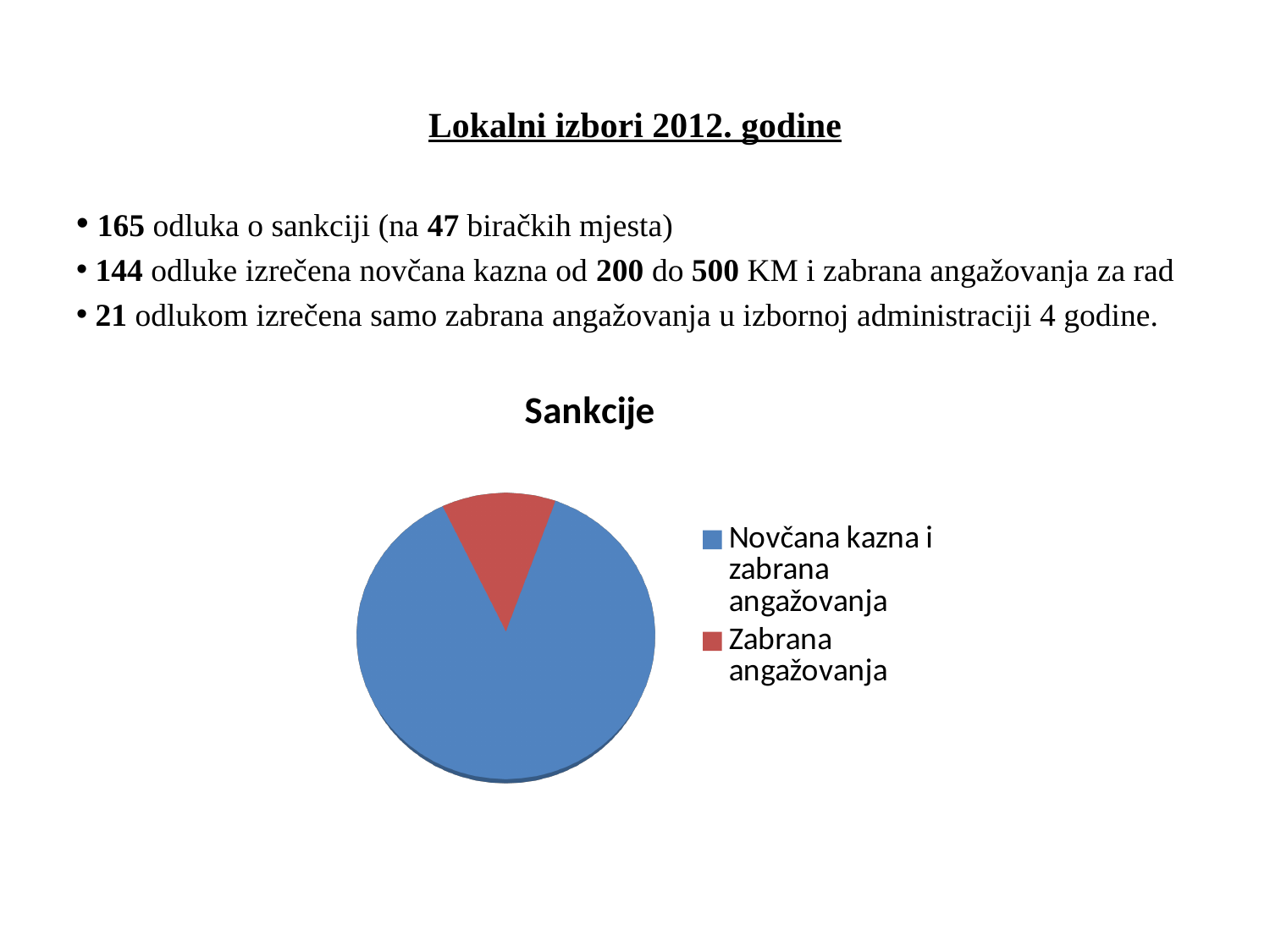
How many entries does the legend of the pie chart list? 2 Which category has the largest slice in the pie chart? Novčana kazna i zabrana angažovanja Which category has the smallest slice in the pie chart? Zabrana angažovanja What colour is the "Zabrana angažovanja" slice in the pie chart? red Does the "Novčana kazna i zabrana angažovanja" slice take up more or less than half of the pie? more What kind of chart is shown under the title "Sankcije"? pie chart Which slice is larger: "Novčana kazna i zabrana angažovanja" or "Zabrana angažovanja"? Novčana kazna i zabrana angažovanja How many slices does the pie chart have? 2 What is the title of the chart on the slide? Sankcije